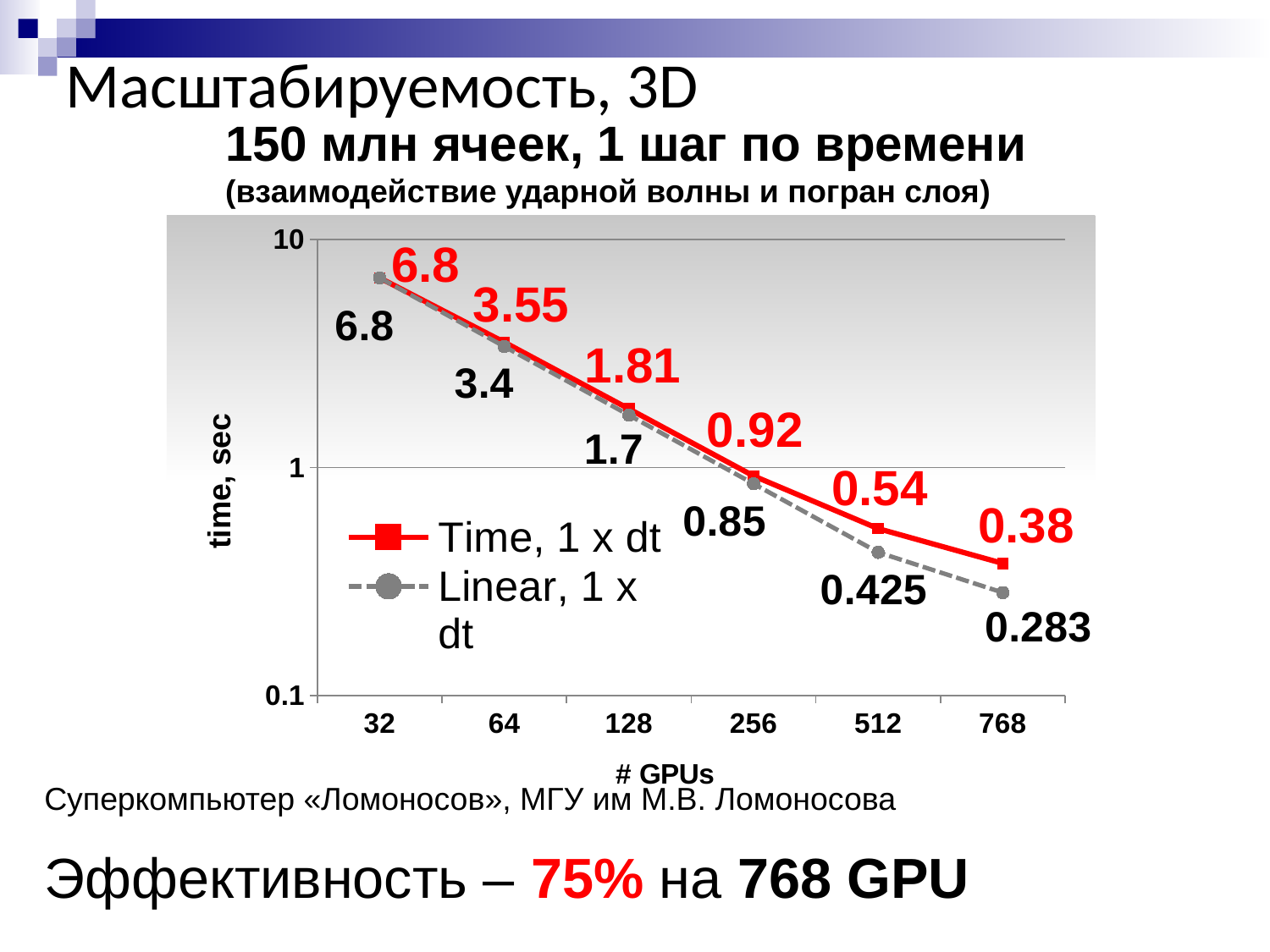
At which number of GPUs is the "Linear, 1 x dt" series highest? 32 At which number of GPUs is the "Time, 1 x dt" series lowest? 768 What is the value of the "Linear, 1 x dt" series at 512 GPUs? 0.425 What is the value of the "Time, 1 x dt" series at 256 GPUs? 0.92 Does the "Time, 1 x dt" series rise or fall as the number of GPUs increases? Fall What is the value of the "Time, 1 x dt" series at 768 GPUs? 0.38 How many series does the legend list? 2 What is the difference between the "Time, 1 x dt" and "Linear, 1 x dt" values at 768 GPUs? 0.097 What is the value of the "Linear, 1 x dt" series at 128 GPUs? 1.7 Which series has the larger value at 512 GPUs, "Time, 1 x dt" or "Linear, 1 x dt"? Time, 1 x dt What kind of chart is shown on the slide? Line chart How many GPU counts are plotted on the x axis? 6